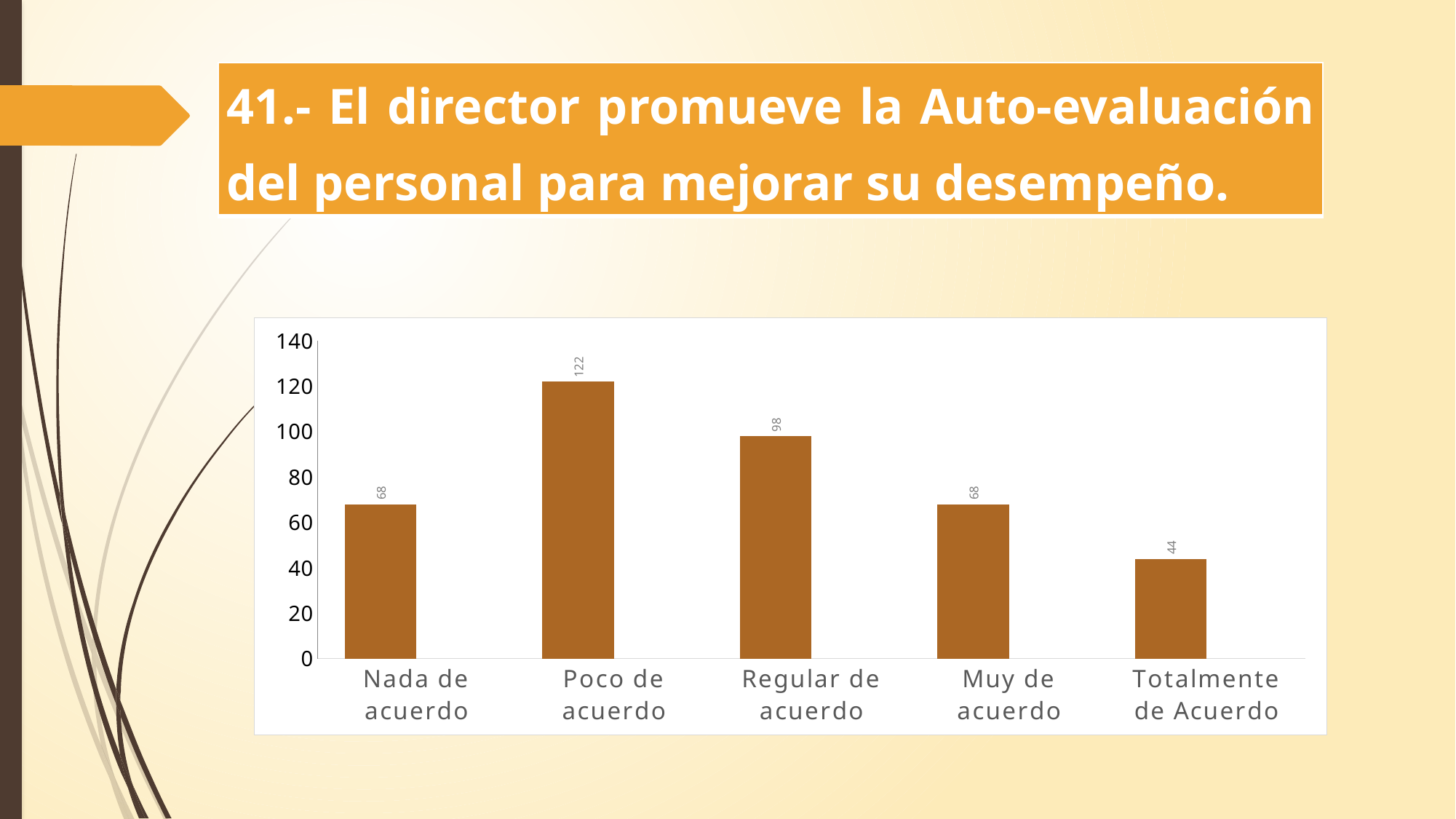
Which category has the lowest value? Totalmente de Acuerdo What is the difference between the values for "Nada de acuerdo" and "Totalmente de Acuerdo"? 24 What is the difference between the values for "Poco de acuerdo" and "Regular de acuerdo"? 24 Is the value for "Poco de acuerdo" greater or less than 100? greater What is the value for "Poco de acuerdo"? 122 Which category has the highest value? Poco de acuerdo What is the value for "Regular de acuerdo"? 98 What kind of chart is shown on the slide? Bar chart Which is larger, the value for "Regular de acuerdo" or the value for "Muy de acuerdo"? Regular de acuerdo How many categories are shown on the x axis? 5 What is the value for "Totalmente de Acuerdo"? 44 What is the highest value shown on the vertical axis? 140